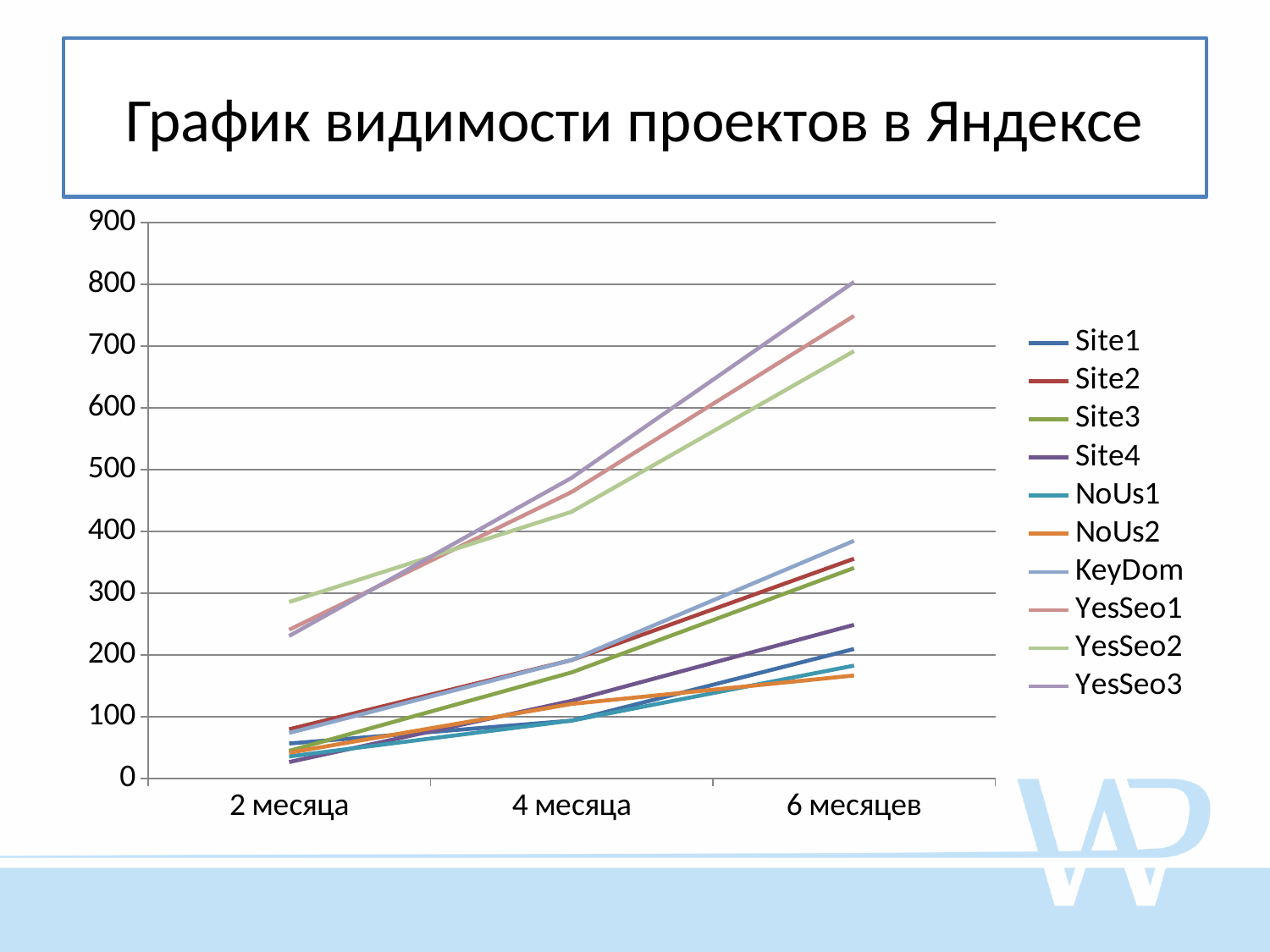
What is the title of the slide? График видимости проектов в Яндексе What kind of chart is shown on the slide? line chart Which series has the lowest value at 2 месяца? Site4 Is the value for YesSeo3 at 6 месяцев greater or less than 700? greater Does the YesSeo3 line rise or fall from 2 месяца to 6 месяцев? rise Which series has the highest value at 6 месяцев? YesSeo3 Is the value for Site4 at 6 месяцев greater or less than 300? less Is the value for YesSeo2 at 2 месяца greater or less than 200? greater Which series has the highest value at 2 месяца? YesSeo2 How many categories are shown on the x axis? 3 At 6 месяцев, which is larger: YesSeo1 or YesSeo2? YesSeo1 How many series does the legend list? 10